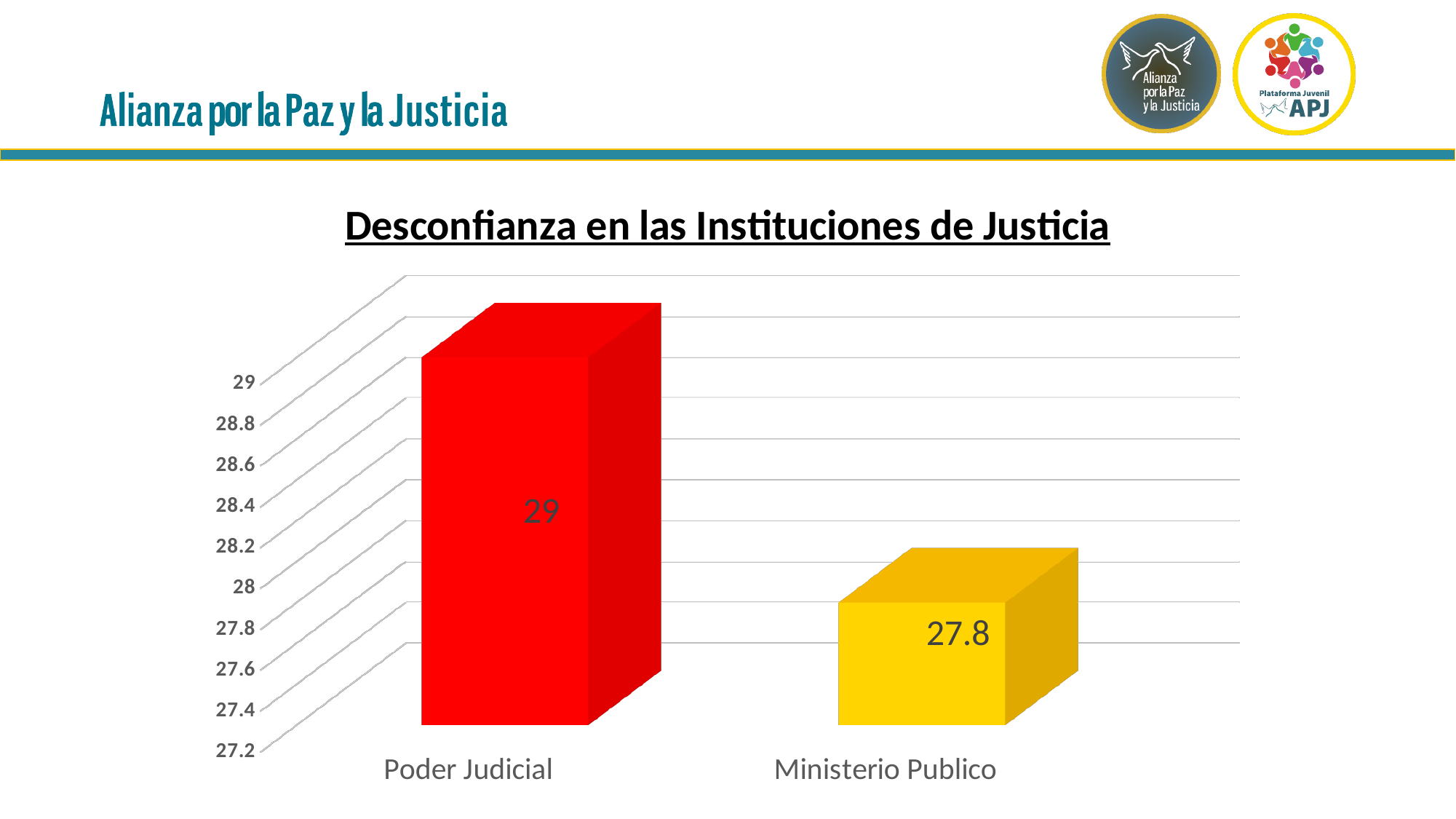
How many categories are shown in the chart? 2 Is the value for Ministerio Publico greater or less than 28? less Which category has the lowest value? Ministerio Publico What colour is the bar for Ministerio Publico? yellow What is the value for Poder Judicial? 29 What is the value for Ministerio Publico? 27.8 What is the difference between the values for Poder Judicial and Ministerio Publico? 1.2 What is the title of the chart? Desconfianza en las Instituciones de Justicia Which category has the highest value? Poder Judicial Is the value for Poder Judicial greater or less than 28.4? greater Which is larger, the value for Poder Judicial or the value for Ministerio Publico? Poder Judicial What kind of chart is shown on the slide? bar chart